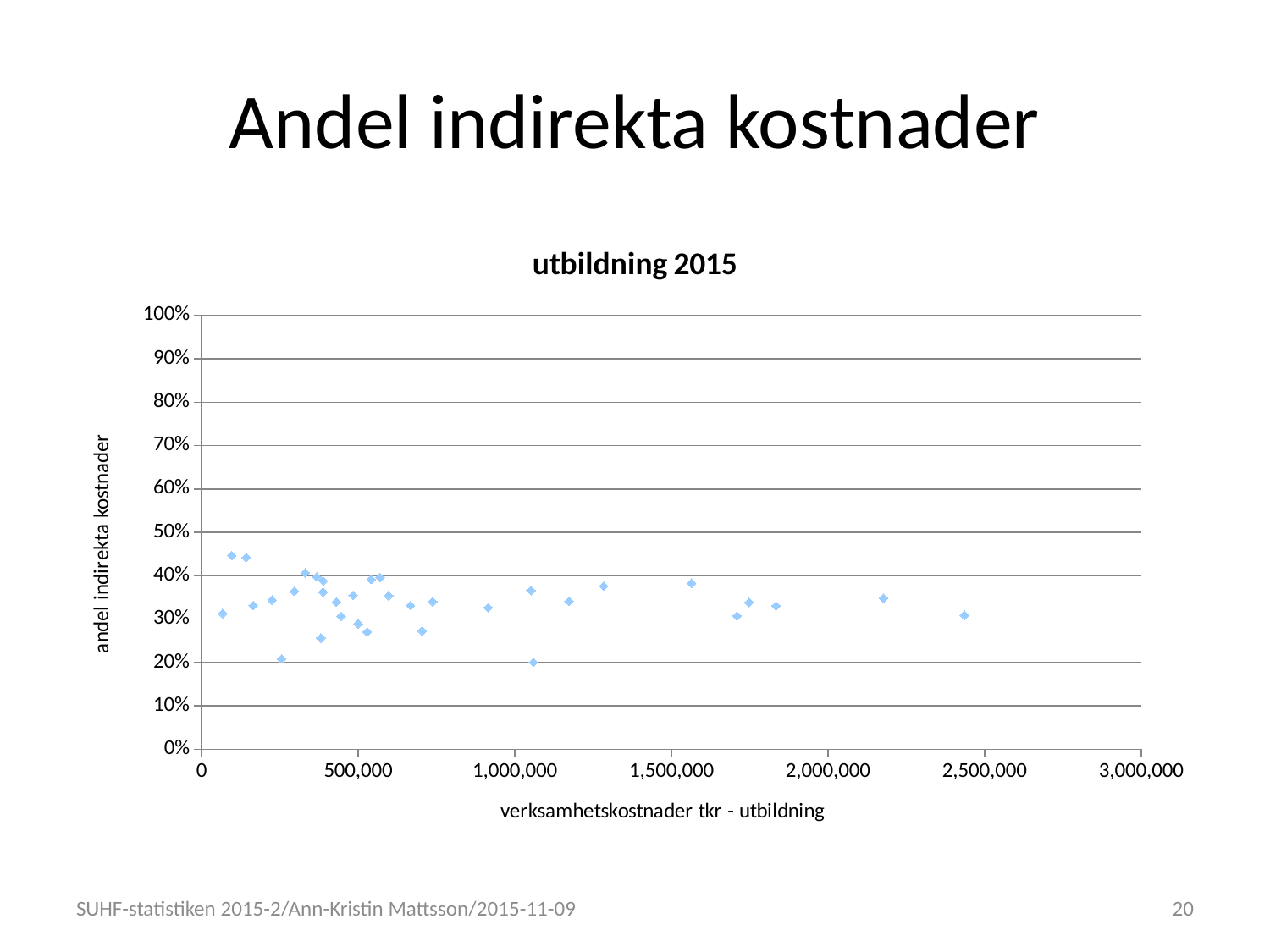
What is the label of the x axis of the chart? verksamhetskostnader tkr - utbildning What kind of chart is shown on the slide? scatter chart Is the value for the point near 1,550,000 on the x axis greater or less than 30%? greater What is the highest value shown on the y axis? 100% Are any of the plotted points above 60% on the y axis? No What is the title of the chart? utbildning 2015 Is the value for the point with the largest x value (around 2,450,000) greater or less than 20%? greater